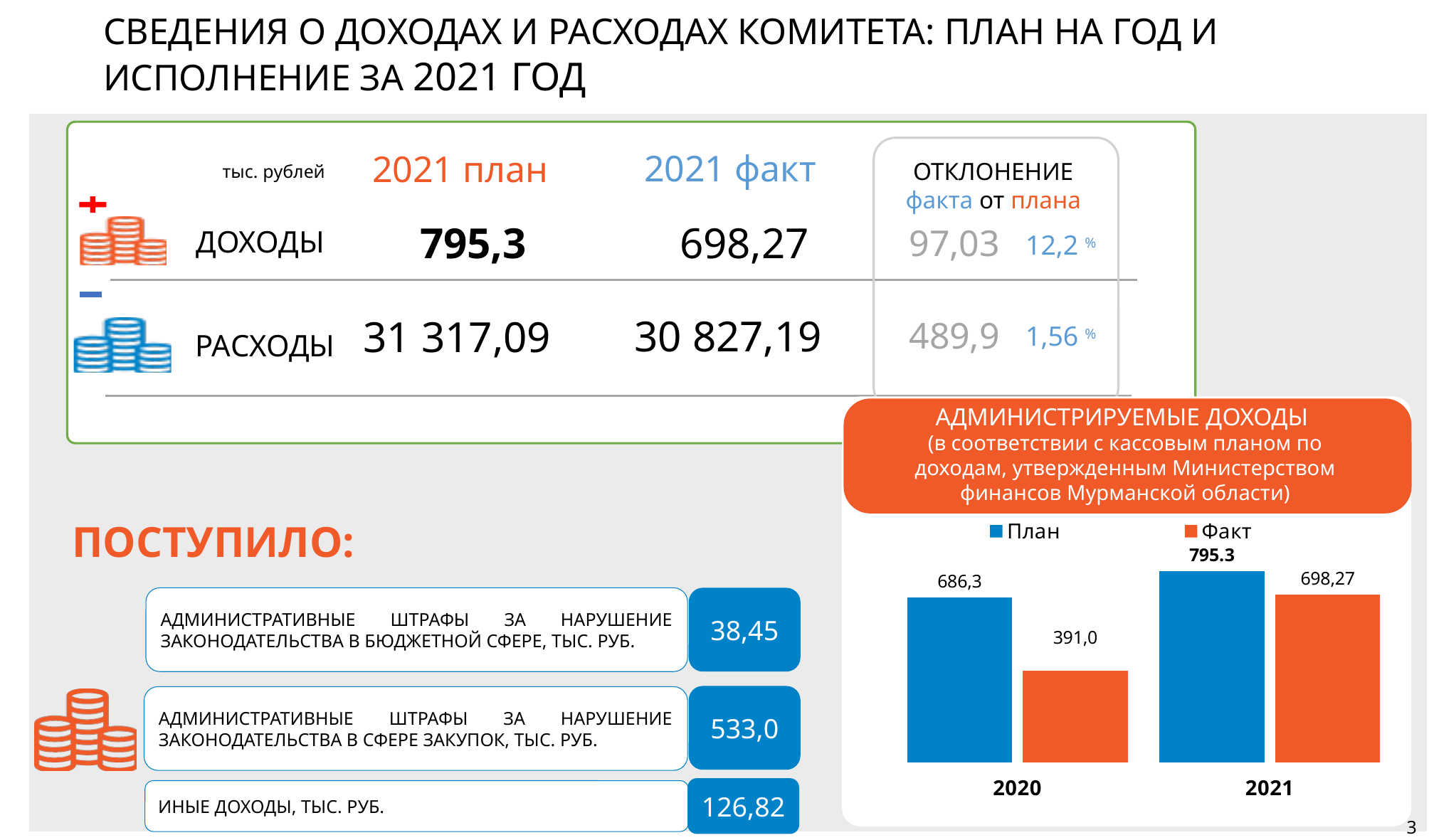
What is the value of Факт for 2021 in the chart? 698,27 What type of chart is shown on the slide? bar chart Which bar in the chart has the lowest value? Факт 2020 What are the two series named in the chart legend? План and Факт Which bar in the chart has the highest value? План 2021 What is the value of Факт for 2020 in the chart? 391,0 How many year categories are shown on the x axis of the chart? 2 How many series does the chart legend list? 2 In the chart, is the Факт value for 2021 larger or smaller than the Факт value for 2020? larger What is the difference between План and Факт for 2020 in the chart? 295,3 What is the value of План for 2020 in the chart? 686,3 What is the value of План for 2021 in the chart? 795.3